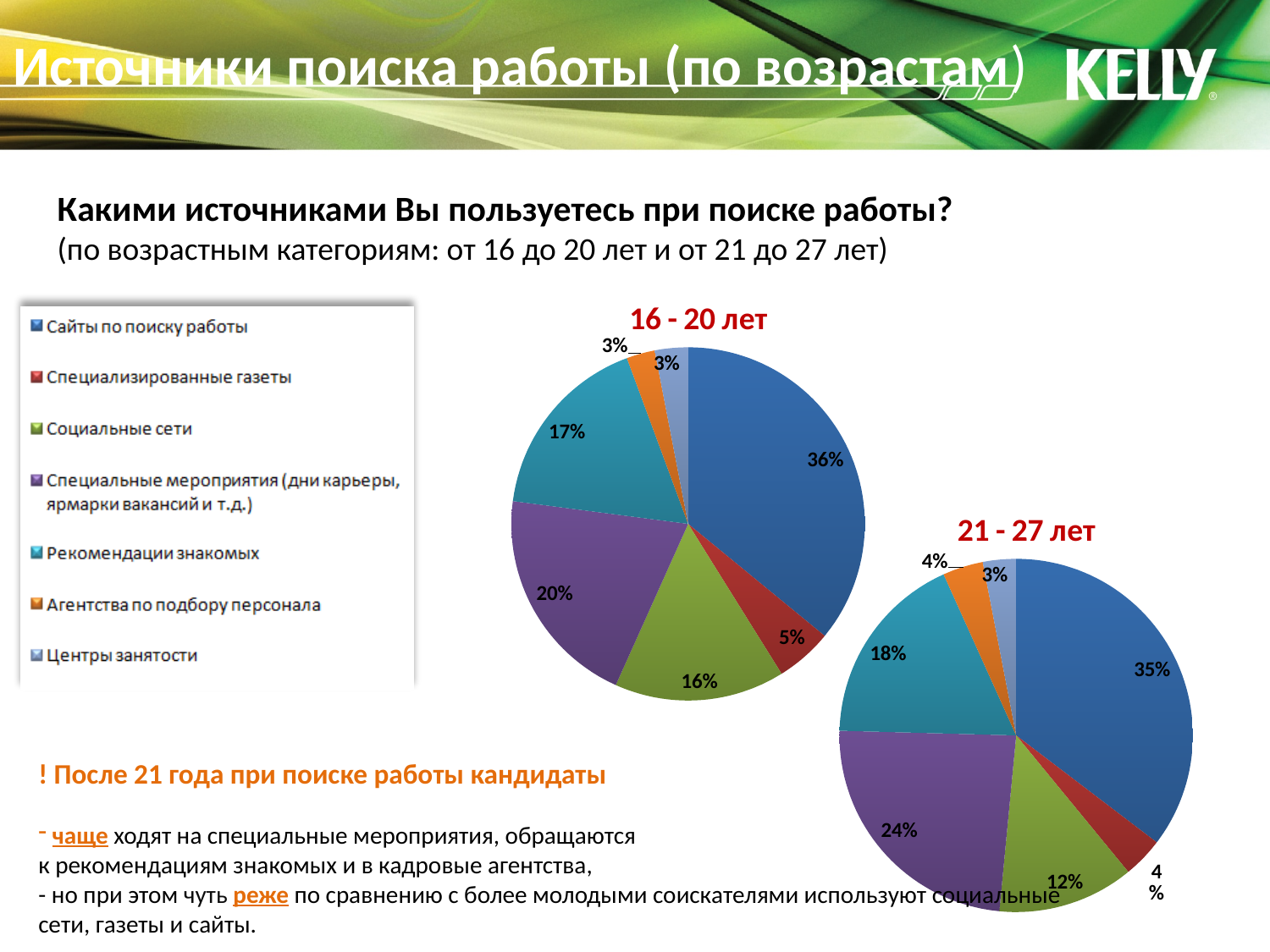
What colour represents Рекомендации знакомых in the pie charts? Teal In the "21 - 27 лет" pie chart, what share is shown for Социальные сети? 12% In the "16 - 20 лет" pie chart, what is the combined share of Агентства по подбору персонала and Центры занятости? 6% What is the difference between the share for Социальные сети in the "16 - 20 лет" chart and in the "21 - 27 лет" chart? 4% In the "16 - 20 лет" pie chart, what share is shown for Сайты по поиску работы? 36% How many categories does the legend list for the pie charts? 7 In the "21 - 27 лет" pie chart, what share is shown for Специальные мероприятия (дни карьеры, ярмарки вакансий и т.д.)? 24% In the "16 - 20 лет" pie chart, what share is shown for Рекомендации знакомых? 17% In the "21 - 27 лет" pie chart, which category has the smallest share? Центры занятости In the "16 - 20 лет" pie chart, which category has the largest share? Сайты по поиску работы Which is larger: the share for Специальные мероприятия in the "16 - 20 лет" chart or in the "21 - 27 лет" chart? 21 - 27 лет What type of chart is used for the "16 - 20 лет" data? Pie chart